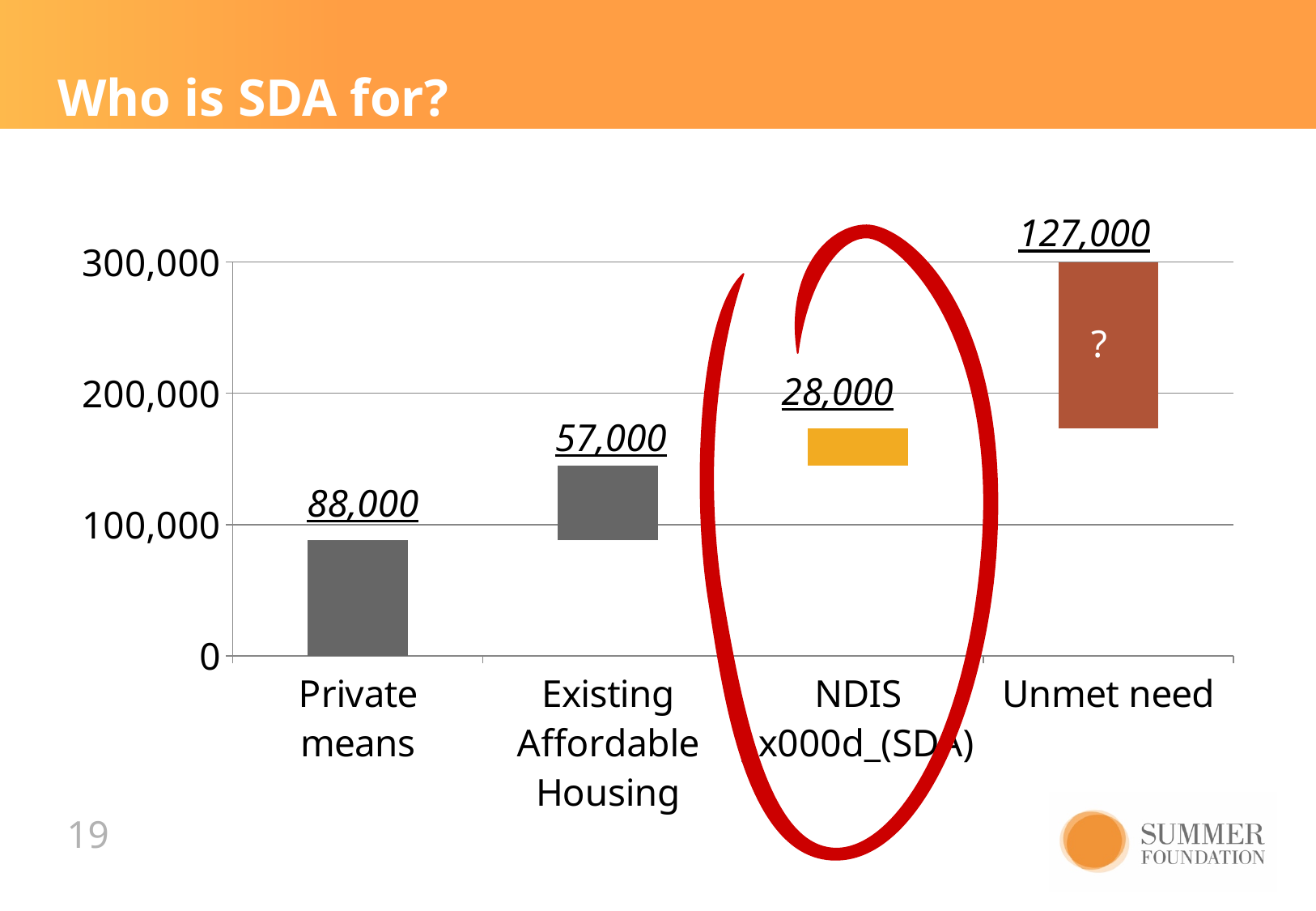
What kind of chart is shown on the slide? Bar chart How many categories are shown on the x axis? 4 Which category has the lowest value? NDIS (SDA) What is the difference between the Unmet need value and the Private means value? 39,000 What is the title of the slide containing the chart? Who is SDA for? Which category has the highest value? Unmet need What is the difference between the Existing Affordable Housing value and the NDIS (SDA) value? 29,000 What is the value shown for NDIS (SDA)? 28,000 Which is larger, the value for Private means or the value for Existing Affordable Housing? Private means What is the value shown for Unmet need? 127,000 What is the value shown for Private means? 88,000 What is the value shown for Existing Affordable Housing? 57,000